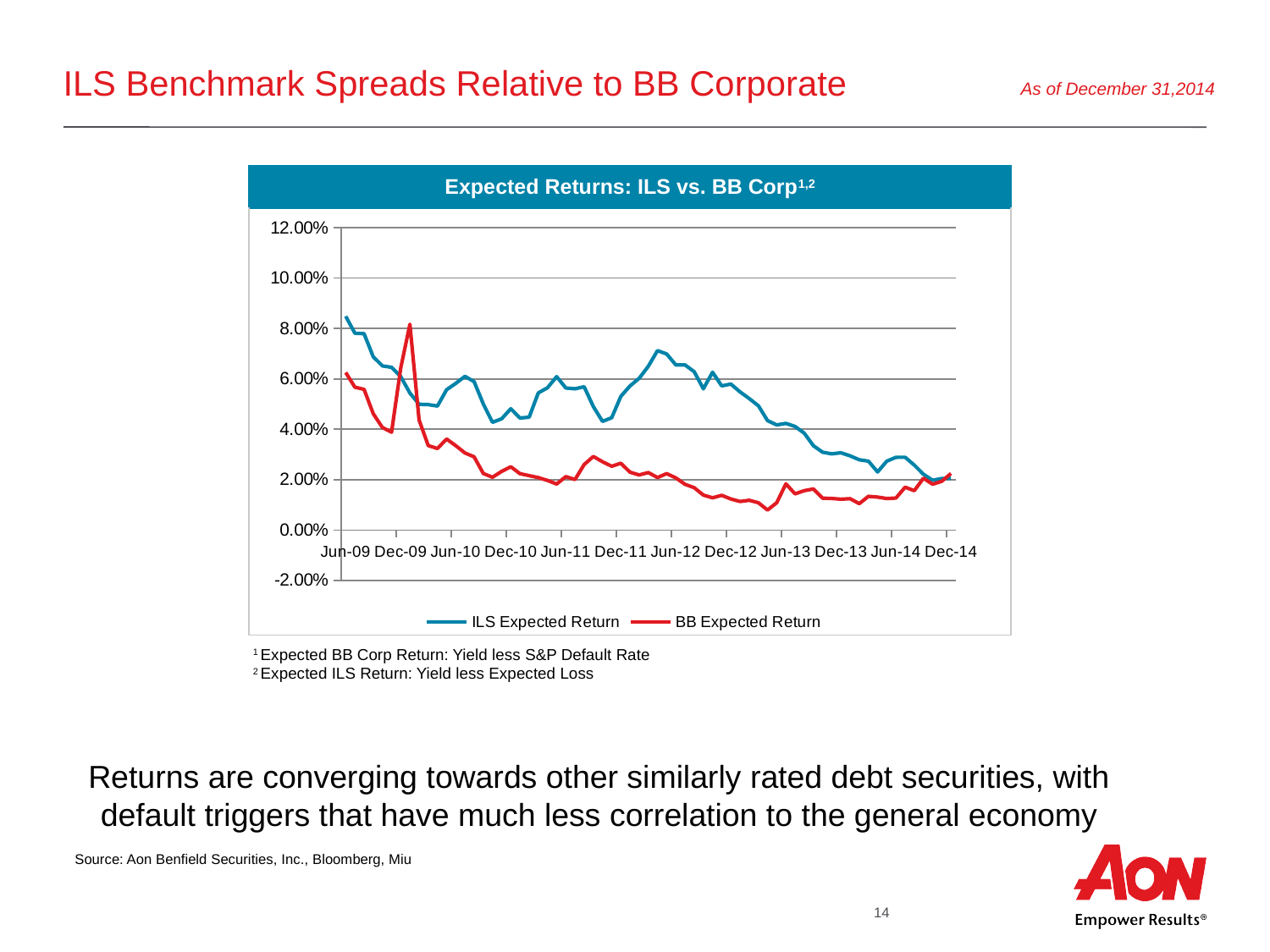
What kind of chart is shown on the slide? line chart How many series does the legend list? 2 Is the ILS Expected Return at Dec-13 greater or less than 4.00%? less Is the BB Expected Return at Dec-12 greater or less than 2.00%? less Does the ILS Expected Return generally rise or fall from Jun-09 to Dec-14? fall At Jun-09, which series has the higher value, ILS Expected Return or BB Expected Return? ILS Expected Return How many date labels are shown along the x axis? 12 At Jun-12, which series has the higher value, ILS Expected Return or BB Expected Return? ILS Expected Return Does the BB Expected Return generally rise or fall from Jun-09 to Dec-14? fall Which colour is used for the BB Expected Return line? red Is the ILS Expected Return at Jun-09 greater or less than 8.00%? greater What is the title of the chart? Expected Returns: ILS vs. BB Corp